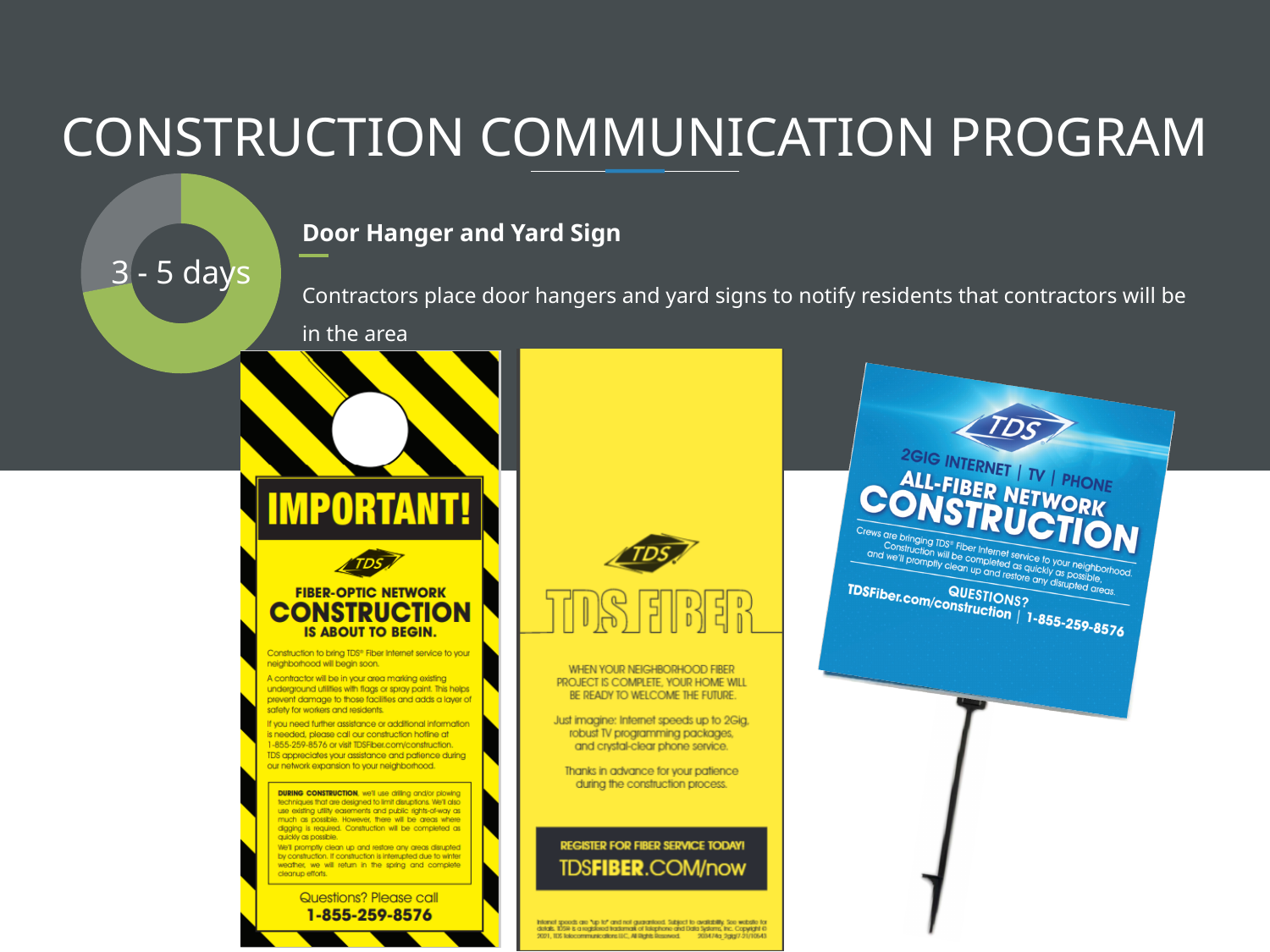
Which segment of the doughnut chart is larger, the green one or the grey one? green Which colour segment takes up the smallest share of the doughnut chart? grey What text is printed in the centre of the doughnut chart? 3 - 5 days What kind of chart is shown on the left of the slide? doughnut chart Does the doughnut chart display a legend? No Which colour segment takes up the largest share of the doughnut chart? green How many segments does the doughnut chart have? 2